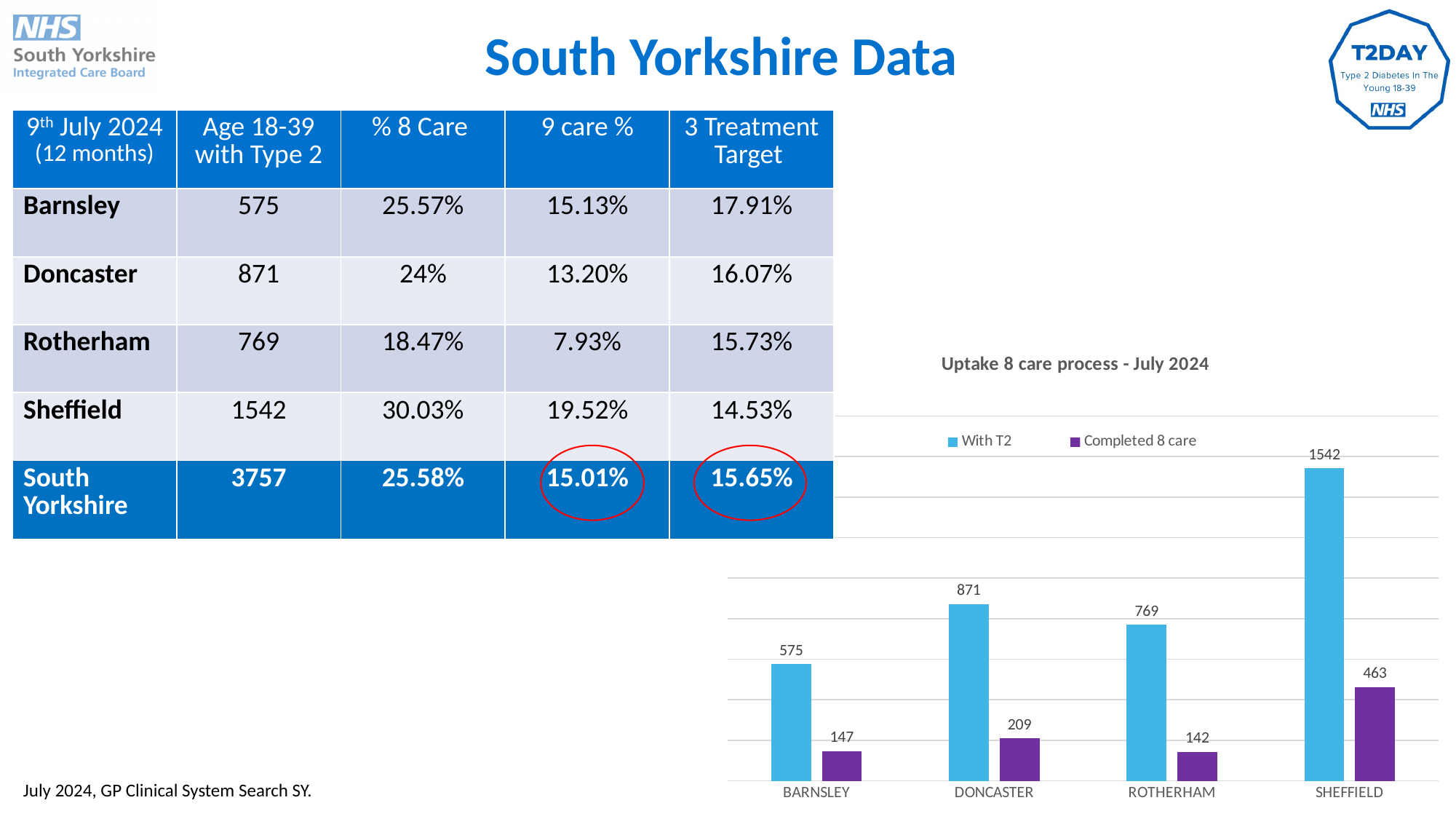
How many series does the legend list? 2 What kind of chart is shown on the slide? Bar chart What is the difference between the With T2 value and the Completed 8 care value for Barnsley? 428 Which category has the highest With T2 value? Sheffield What is the value for Completed 8 care for Doncaster? 209 What is the value for With T2 for Sheffield? 1542 How many categories are shown on the x axis? 4 Which category has the lowest Completed 8 care value? Rotherham What is the value for With T2 for Rotherham? 769 Which is larger, the With T2 value for Doncaster or the With T2 value for Rotherham? Doncaster What is the title of the chart? Uptake 8 care process - July 2024 What is the difference between the Completed 8 care values for Sheffield and Doncaster? 254